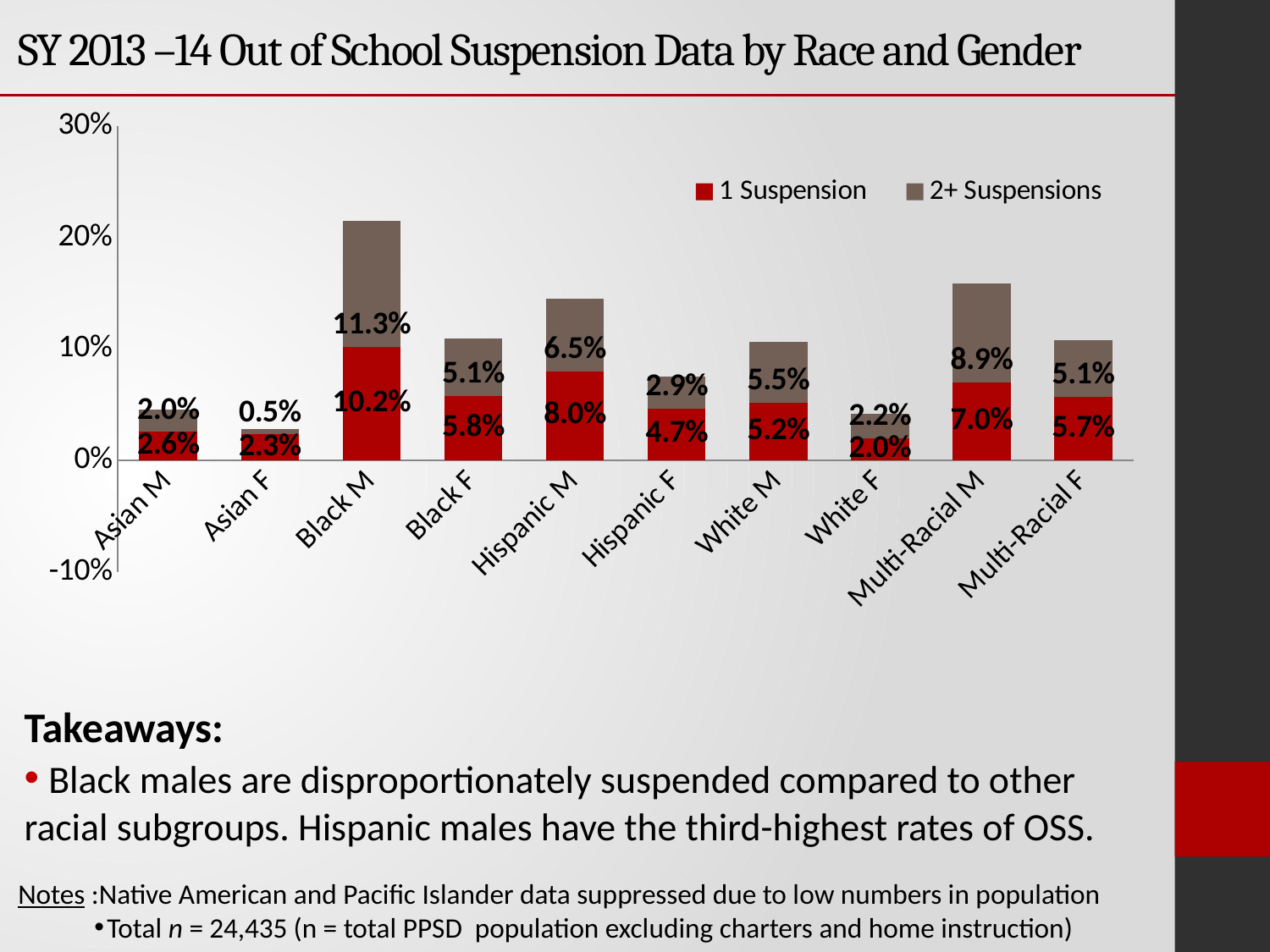
What is the value for 1 Suspension for Black M? 10.2% Which category has the highest value for 2+ Suspensions? Black M Which is larger, the 1 Suspension value for White M or for Multi-Racial F? Multi-Racial F What is the value for 2+ Suspensions for Multi-Racial M? 8.9% What kind of chart is shown on the slide? Stacked bar chart What is the total of the stacked bar for Hispanic M? 14.5% What is the value for 1 Suspension for Hispanic F? 4.7% How many series does the legend list? 2 What is the total of the stacked bar for Black M? 21.5% What is the difference between the 1 Suspension values for Black M and Hispanic M? 2.2% Which category has the lowest value for 2+ Suspensions? Asian F How many categories are shown on the x axis? 10